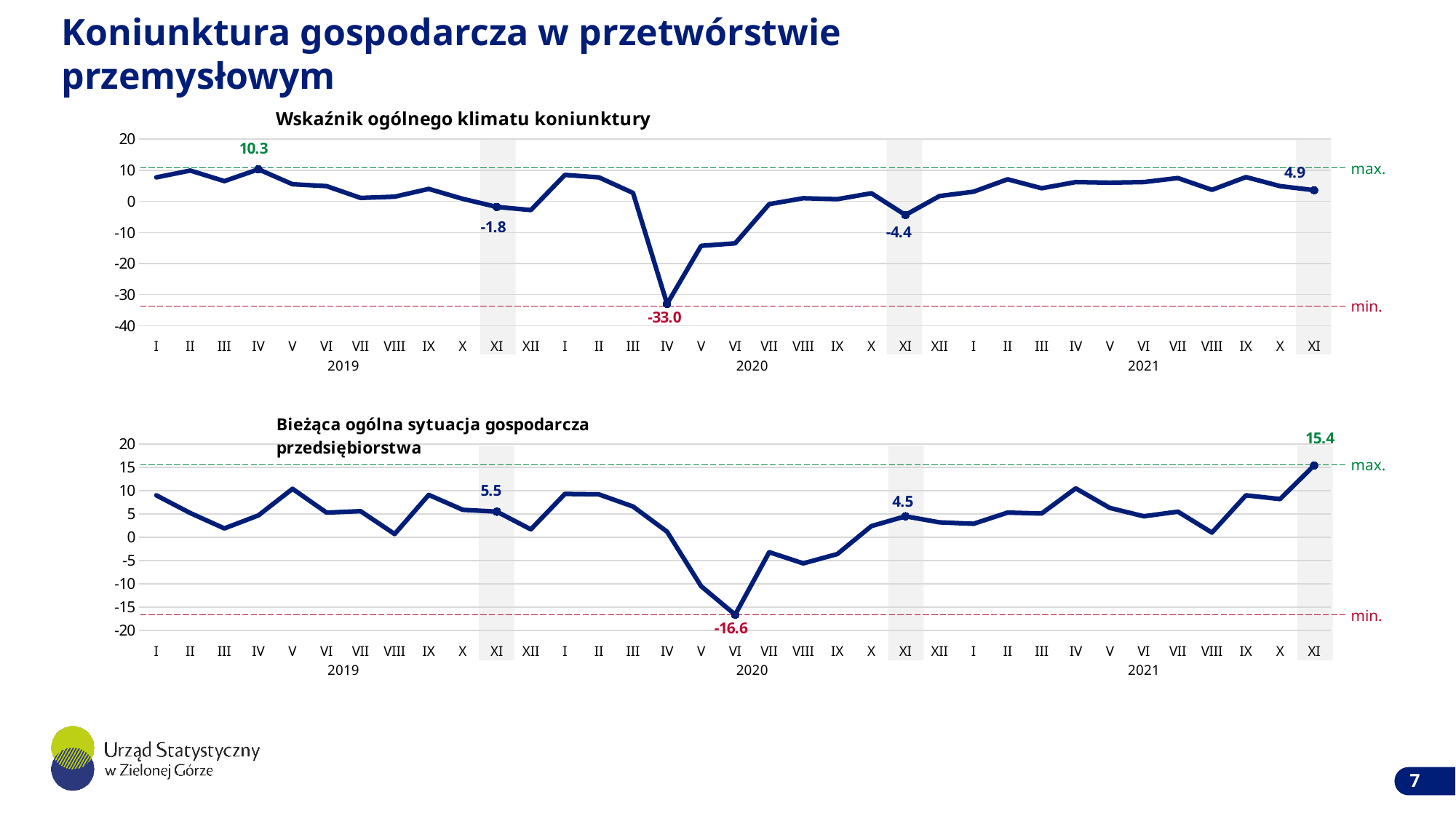
What kind of chart is the top chart 'Wskaźnik ogólnego klimatu koniunktury'? line chart In the bottom chart 'Bieżąca ogólna sytuacja gospodarcza przedsiębiorstwa', what is the difference between the values for XI 2021 (15.4) and XI 2020 (4.5)? 10.9 In the top chart 'Wskaźnik ogólnego klimatu koniunktury', what is the value labelled for IV 2020? -33.0 In the bottom chart 'Bieżąca ogólna sytuacja gospodarcza przedsiębiorstwa', what is the minimum value marked on the chart? -16.6 In the top chart 'Wskaźnik ogólnego klimatu koniunktury', is the value for V 2020 greater or less than -10? less In the top chart 'Wskaźnik ogólnego klimatu koniunktury', what is the value labelled for XI 2021? 4.9 In the bottom chart 'Bieżąca ogólna sytuacja gospodarcza przedsiębiorstwa', which is larger: the value for XI 2019 or the value for XI 2020? XI 2019 In the top chart 'Wskaźnik ogólnego klimatu koniunktury', in which month and year does the minimum value of -33.0 occur? IV 2020 In the bottom chart 'Bieżąca ogólna sytuacja gospodarcza przedsiębiorstwa', do the values rise or fall between VIII 2021 and XI 2021? rise In the bottom chart 'Bieżąca ogólna sytuacja gospodarcza przedsiębiorstwa', what is the value labelled for XI 2021? 15.4 In the top chart 'Wskaźnik ogólnego klimatu koniunktury', what is the difference between the values for XI 2019 (-1.8) and XI 2020 (-4.4)? 2.6 In the top chart 'Wskaźnik ogólnego klimatu koniunktury', what is the maximum value marked on the chart? 10.3